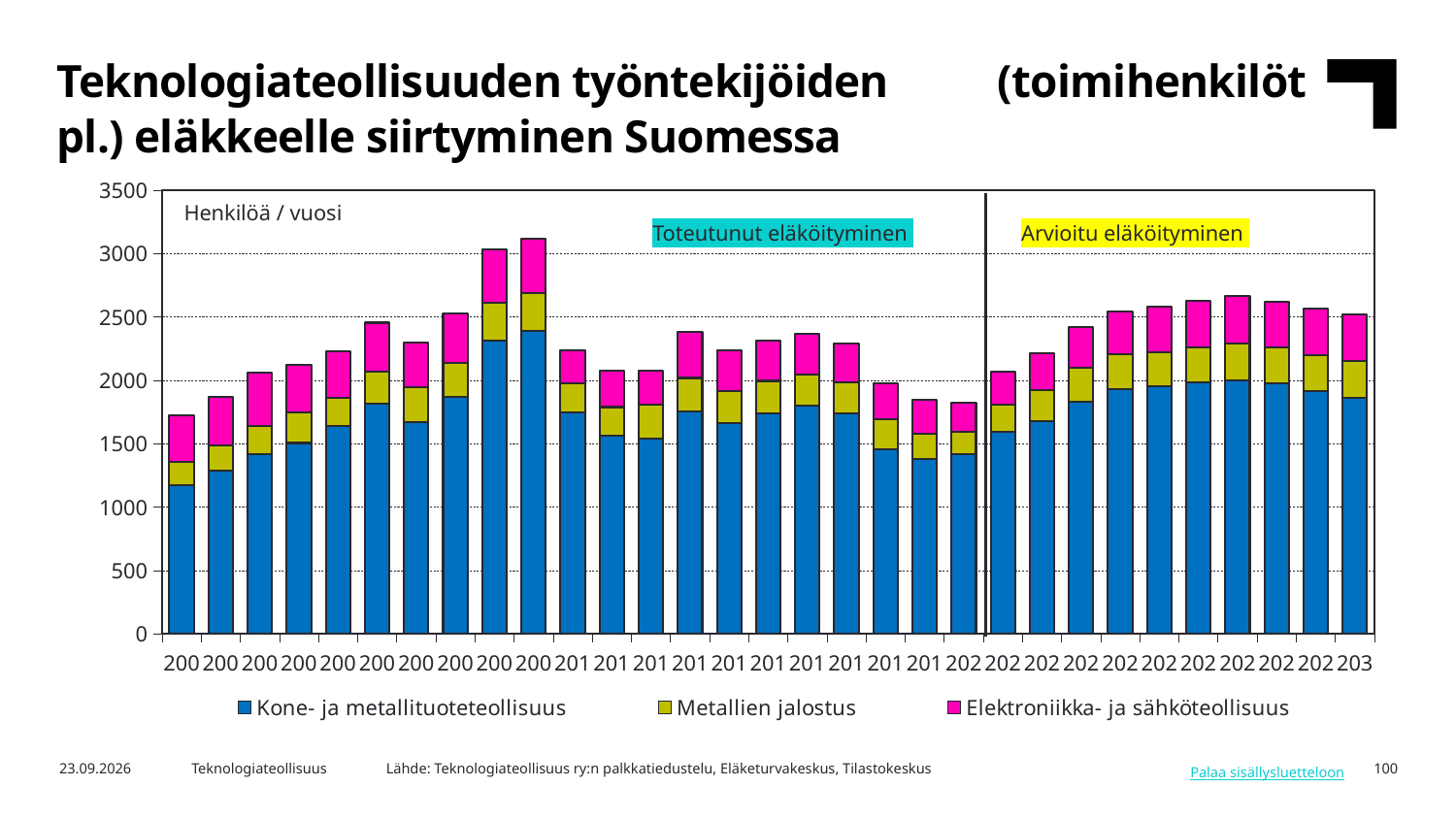
How many bars (years) are plotted in the chart? 31 Is the total of the tallest stacked bar greater or less than 3000? greater What unit label is shown at the top left of the plot area? Henkilöä / vuosi Is the total of the shortest stacked bar greater or less than 1500? greater How many series does the legend list? 3 What kind of chart is shown on the slide? Stacked bar chart Which series is shown in blue in the legend? Kone- ja metallituoteteollisuus